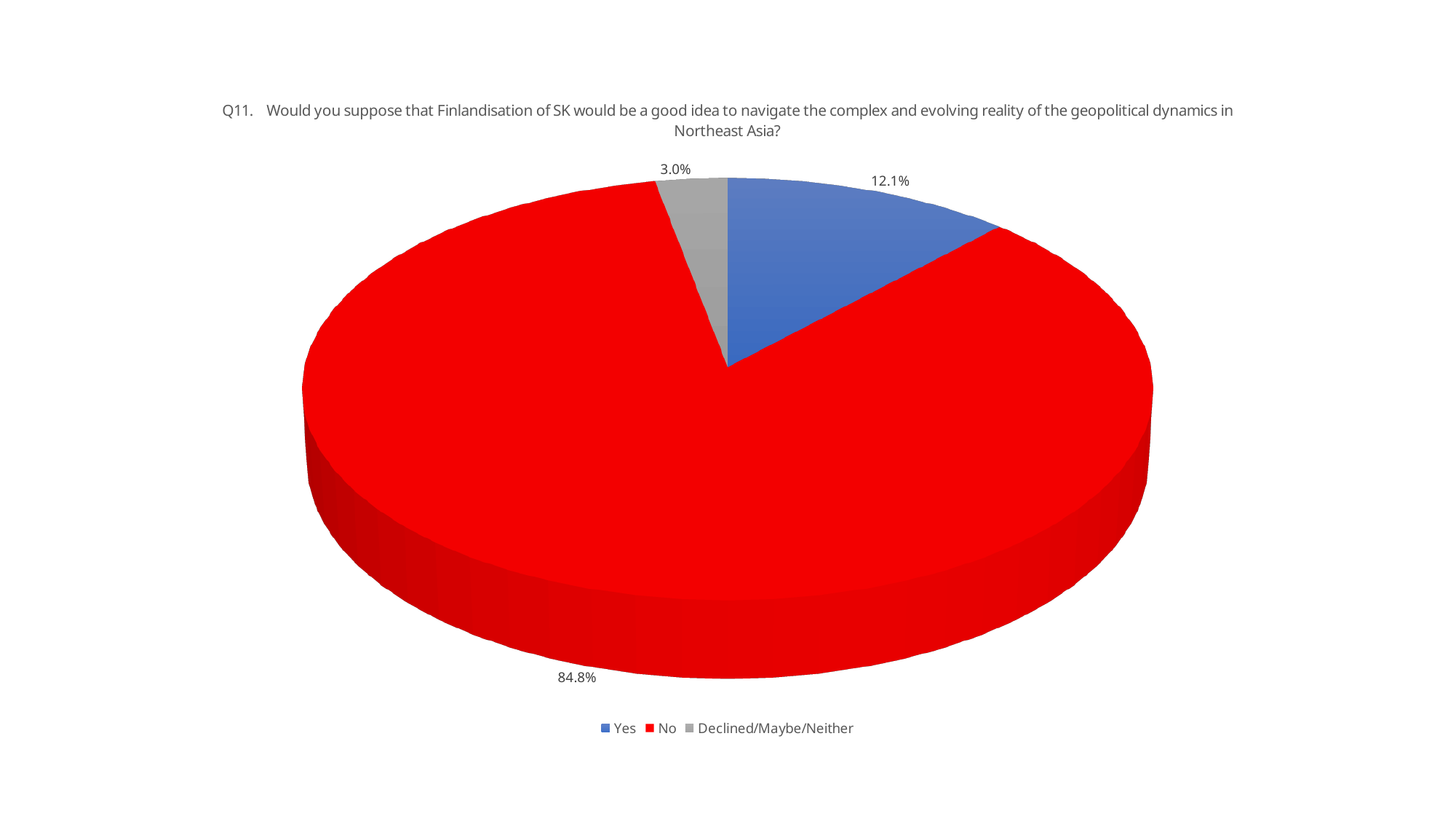
How many entries does the legend list? 3 What percentage of respondents answered "No"? 84.8% Which response has the largest share of the pie? No What percentage of respondents answered "Declined/Maybe/Neither"? 3.0% What is the difference in percentage points between the "No" share and the "Yes" share? 72.7 percentage points What kind of chart is shown on the slide? Pie chart What percentage of respondents answered "Yes"? 12.1% Which is larger, the share for "Yes" or the share for "Declined/Maybe/Neither"? Yes Which response has the smallest share of the pie? Declined/Maybe/Neither What colour is the "No" slice? Red How many slices does the pie chart have? 3 What colour is the "Yes" slice? Blue